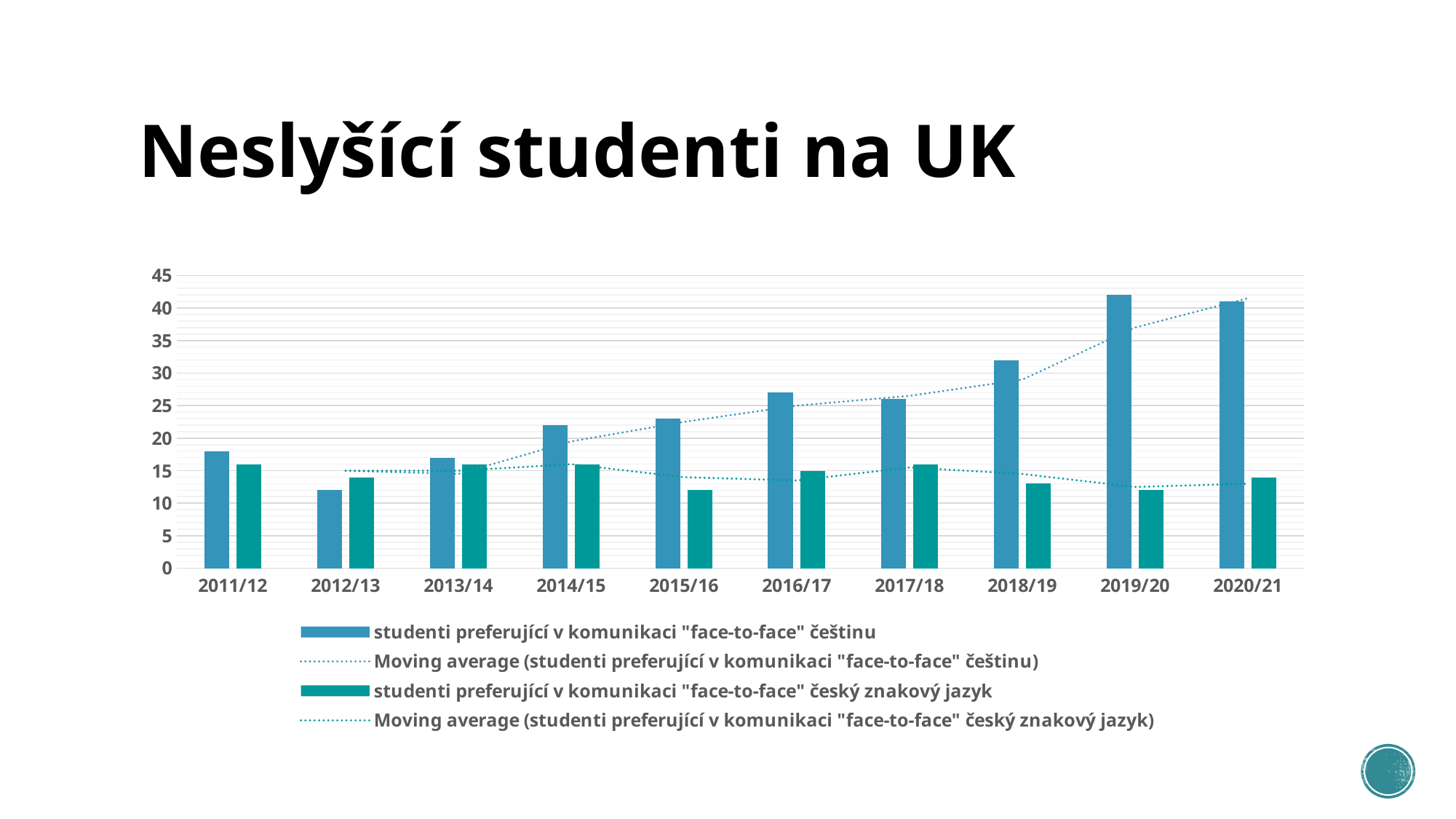
In 2018/19, which group has the larger bar: students preferring Czech or students preferring Czech sign language? students preferring Czech Is the value for students preferring Czech sign language ("český znakový jazyk") in 2015/16 greater or less than 15? less Is the value for students preferring Czech in 2012/13 greater or less than 15? less What is the title of the slide containing the chart? Neslyšící studenti na UK What kind of chart is shown on the slide? bar chart How many entries does the chart legend list? 4 Is the value for students preferring Czech in 2019/20 greater or less than 40? greater In which academic year is the bar for students preferring Czech ("studenti preferující v komunikaci "face-to-face" češtinu") the lowest? 2012/13 Do the bars for students preferring Czech generally rise or fall from 2011/12 to 2020/21? rise How many academic years are shown on the x axis of the chart? 10